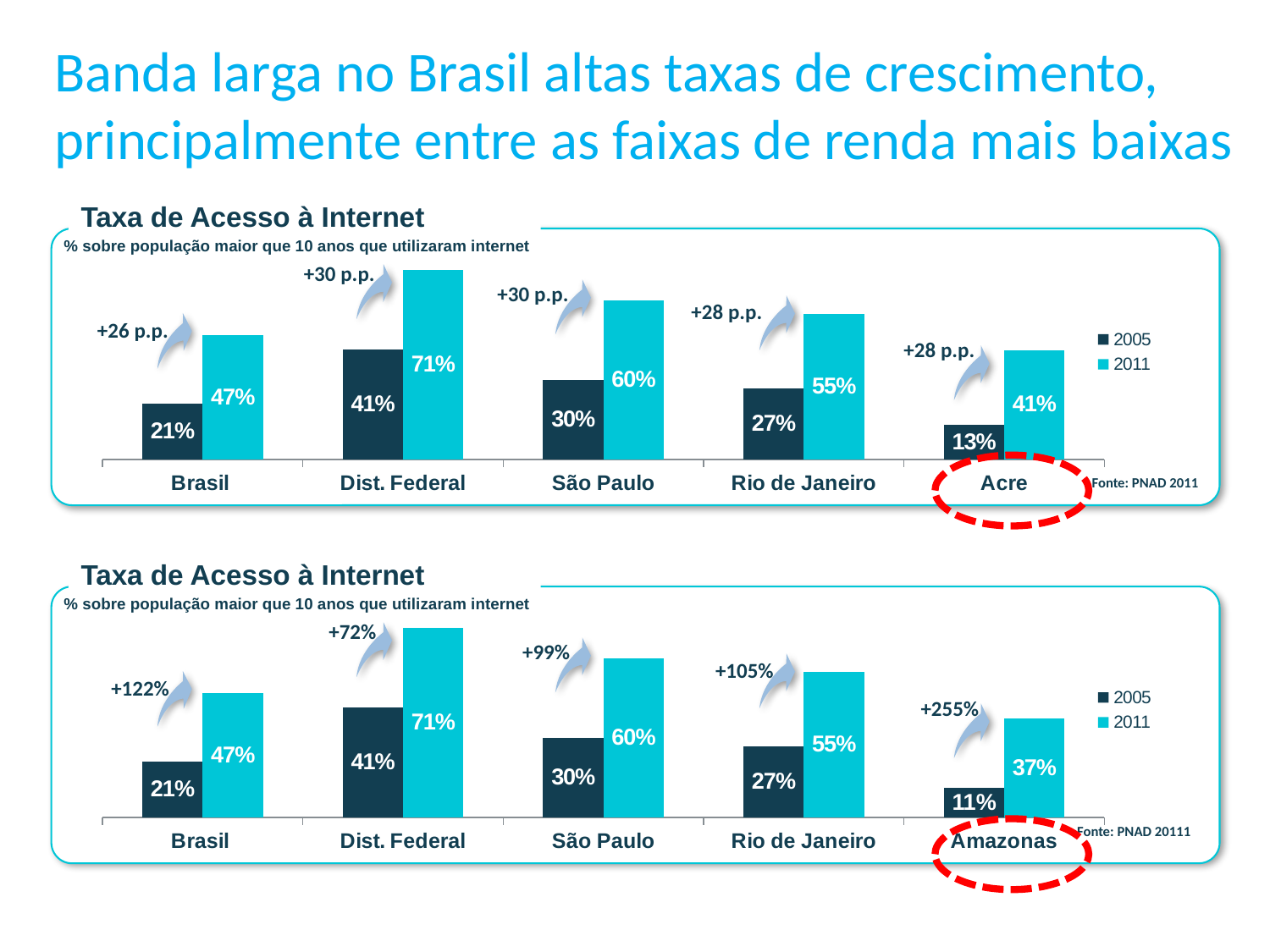
In the bottom chart, what percentage growth is annotated above the Amazonas bars? +255% In the bottom chart, what is the 2011 value for Amazonas? 37% In the top chart, which category has the highest 2011 value? Dist. Federal What kind of chart is the bottom chart? Bar chart In the top chart, which category has the lowest 2005 value? Acre How many categories are shown on the x axis of the bottom chart? 5 In the top chart, which is larger: the 2011 value for Rio de Janeiro or the 2011 value for Acre? Rio de Janeiro In the bottom chart, what is the 2005 value for Amazonas? 11% How many series does the legend of the top chart list? 2 In the top chart, what is the 2005 value for Dist. Federal? 41% In the top chart, what is the 2011 value for Acre? 41% In the bottom chart, what is the difference between the 2011 and 2005 values for São Paulo? 30%